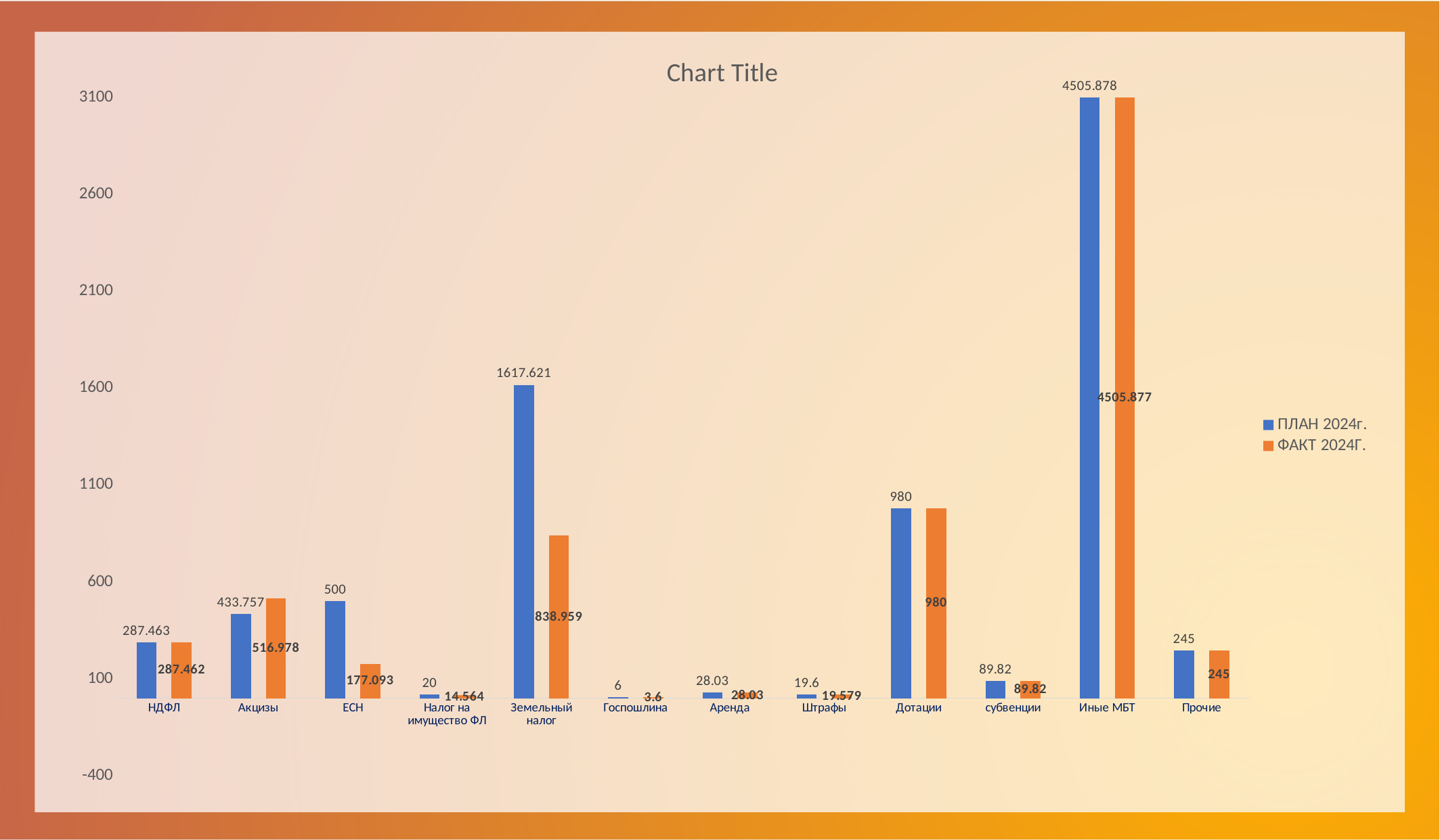
Which category has the highest ПЛАН 2024г. value? Иные МБТ What type of chart is shown on the slide? bar chart What is the difference between the ПЛАН 2024г. and ФАКТ 2024Г. values for ЕСН? 322.907 Which category has the lowest ФАКТ 2024Г. value? Госпошлина For Акцизы, which is larger: the ПЛАН 2024г. value or the ФАКТ 2024Г. value? ФАКТ 2024Г. How many series does the legend list? 2 What is the ФАКТ 2024Г. value for Акцизы? 516.978 What is the ФАКТ 2024Г. value for ЕСН? 177.093 How many categories are shown on the x axis? 12 What is the ПЛАН 2024г. value for Госпошлина? 6 What is the ПЛАН 2024г. value for Земельный налог? 1617.621 What is the title of the chart? Chart Title